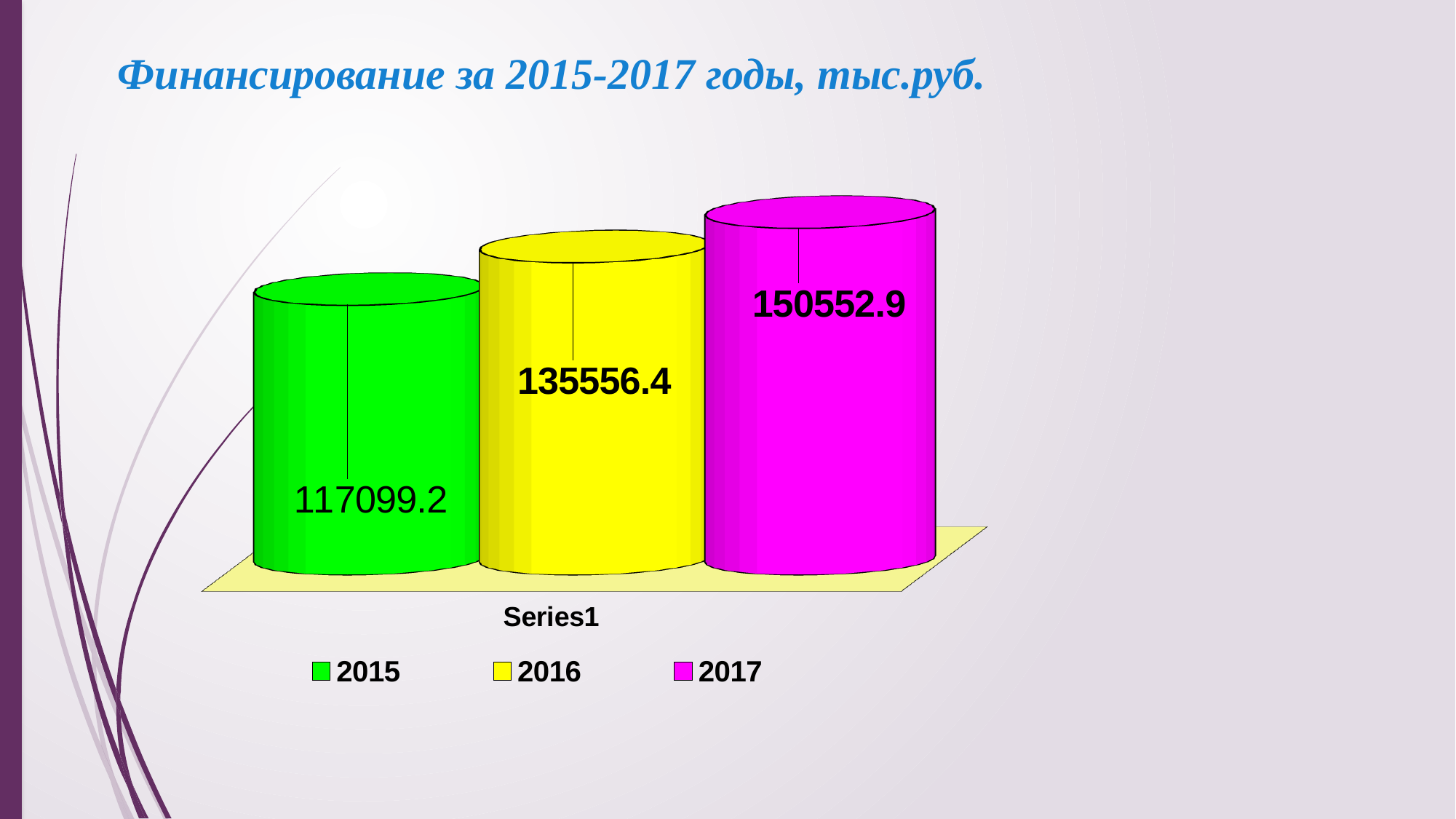
What kind of chart is shown on the slide? Bar chart What is the value shown for 2015? 117099.2 How many series does the legend list? 3 What is the difference between the values for 2016 and 2015? 18457.2 What is the difference between the values for 2017 and 2015? 33453.7 What is the title of the chart? Финансирование за 2015-2017 годы, тыс.руб. Which year has the highest value? 2017 Which year has the lowest value? 2015 What is the difference between the values for 2017 and 2016? 14996.5 What is the value shown for 2016? 135556.4 What is the value shown for 2017? 150552.9 Which is larger, the value for 2016 or the value for 2017? 2017